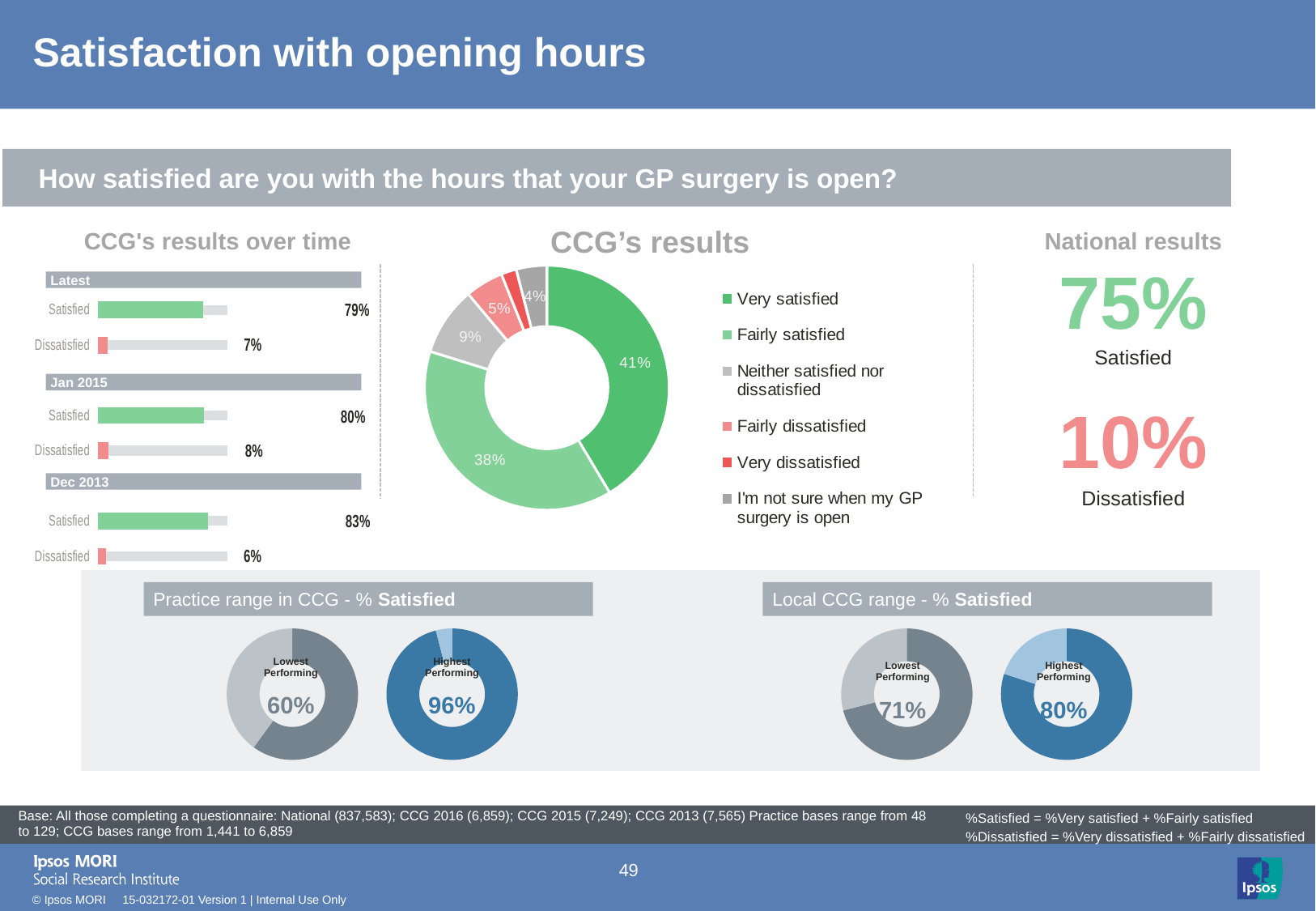
In the 'CCG's results over time' chart, what is the Dissatisfied value for Jan 2015? 8% In the 'CCG's results over time' chart, what is the difference between the Satisfied values for Dec 2013 and Latest? 4 percentage points In the 'Local CCG range - % Satisfied' section, what is the difference between the Highest Performing and Lowest Performing values? 9 percentage points In the 'CCG's results over time' chart, which period has the lowest Dissatisfied value? Dec 2013 In the 'CCG's results over time' chart, does the Satisfied value rise or fall from Dec 2013 to Latest? fall In the 'CCG's results over time' chart, what is the Satisfied value for Latest? 79% In the 'Practice range in CCG - % Satisfied' section, what is the Highest Performing value? 96% How many entries does the legend of the 'CCG's results' donut chart list? 6 In the 'CCG's results' donut chart, which category has the largest share? Very satisfied In the 'CCG's results' donut chart, what percentage is Very satisfied? 41% In the 'CCG's results over time' chart, which period has the highest Satisfied value? Dec 2013 In the 'CCG's results' donut chart, what percentage is Fairly satisfied? 38%